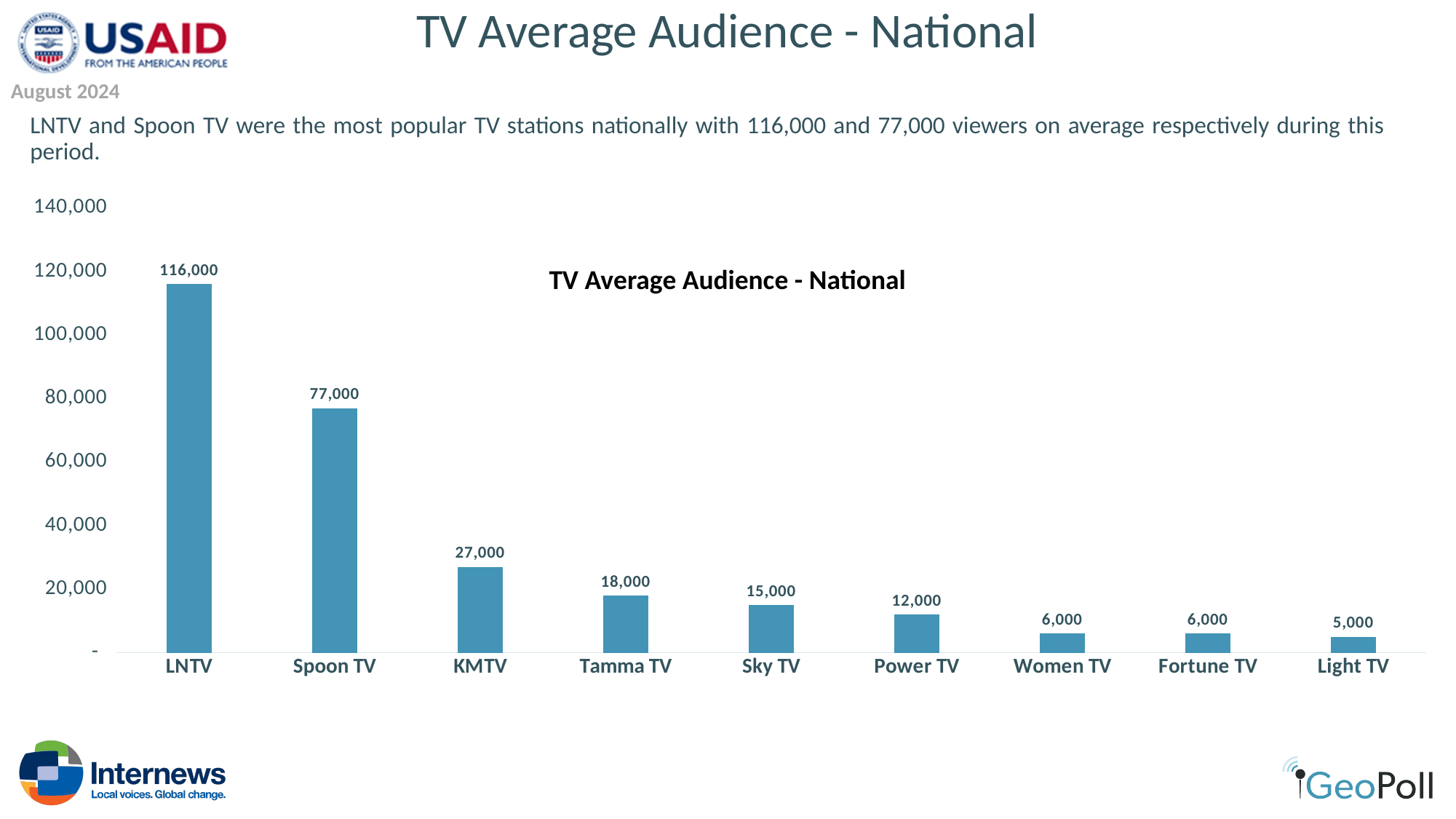
What is the title of the chart? TV Average Audience - National Which TV station has the highest average audience? LNTV What kind of chart is shown on the slide? Bar chart What is the difference between the average audience of LNTV and Spoon TV? 39,000 What is the average audience for KMTV? 27,000 How many TV stations are shown in the chart? 9 What is the difference between the average audience of Tamma TV and Sky TV? 3,000 Is the value for Spoon TV greater or less than 80,000? less What is the average audience for Power TV? 12,000 What is the average audience for LNTV? 116,000 Which has a larger average audience, KMTV or Tamma TV? KMTV Which TV station has the lowest average audience? Light TV